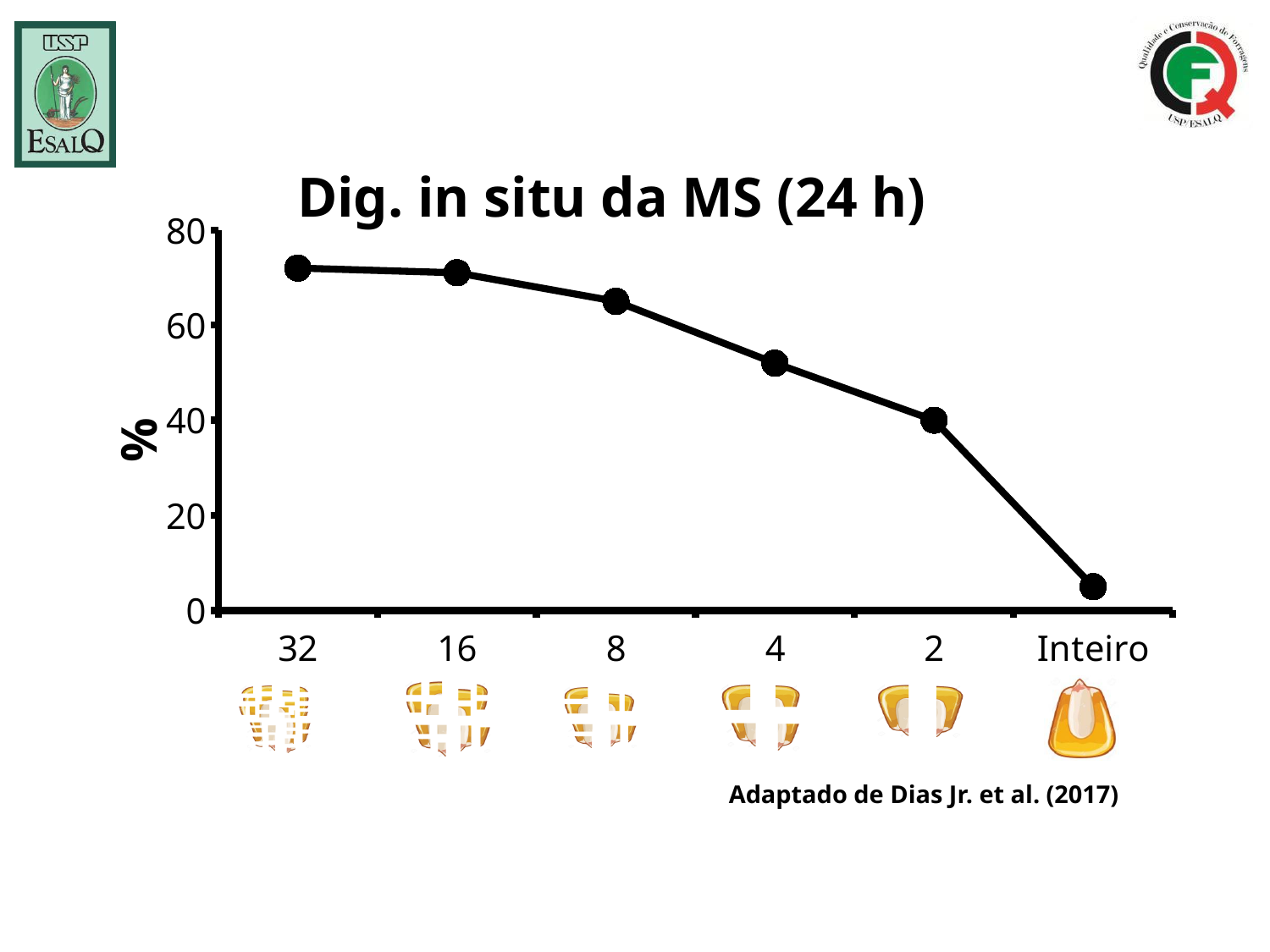
What is the title of the chart? Dig. in situ da MS (24 h) Is the value for 4 greater or less than 60? less How many data points are plotted on the line? 6 Is the value for 8 greater or less than 60? greater Which has the larger value, 2 or Inteiro? 2 Which category has the lowest value? Inteiro Do the values rise or fall moving from 32 to Inteiro along the x axis? fall Which has the larger value, 8 or 4? 8 What kind of chart is shown on the slide? line chart Is the value for 32 greater or less than 60? greater What is the label on the y axis of the chart? %